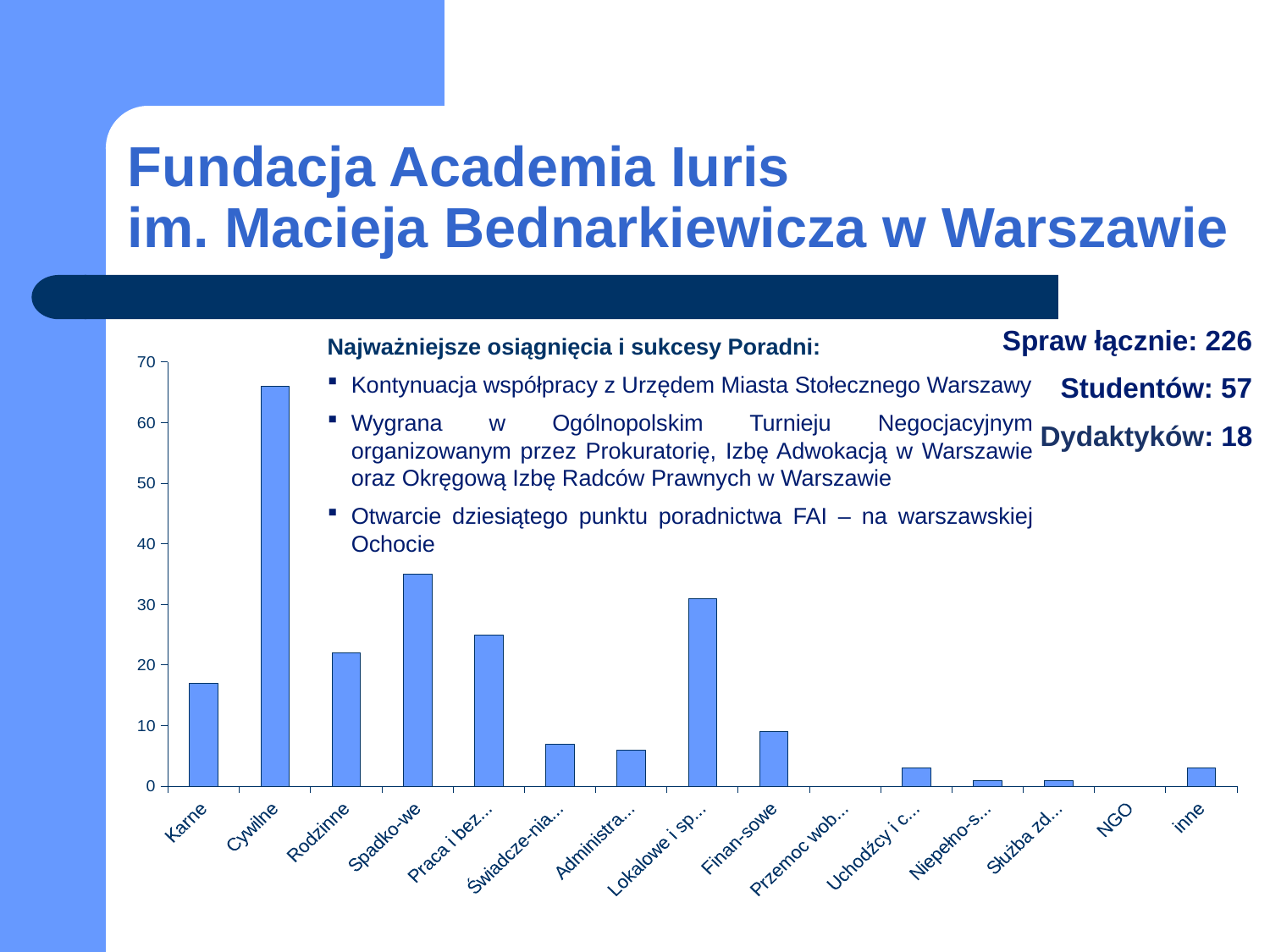
Is the value for Karne greater or less than 20? less Is the value for Praca i bez... greater or less than 30? less What kind of chart is shown on the slide? bar chart Which category has the highest value in the bar chart? Cywilne Is the value for Świadcze-nia... greater or less than 10? less Which is larger, the value for Spadko-we or the value for Praca i bez...? Spadko-we How many categories are shown on the x axis of the bar chart? 15 Which is larger, the value for Lokalowe i sp... or the value for Rodzinne? Lokalowe i sp... What is the highest tick value shown on the y axis of the bar chart? 70